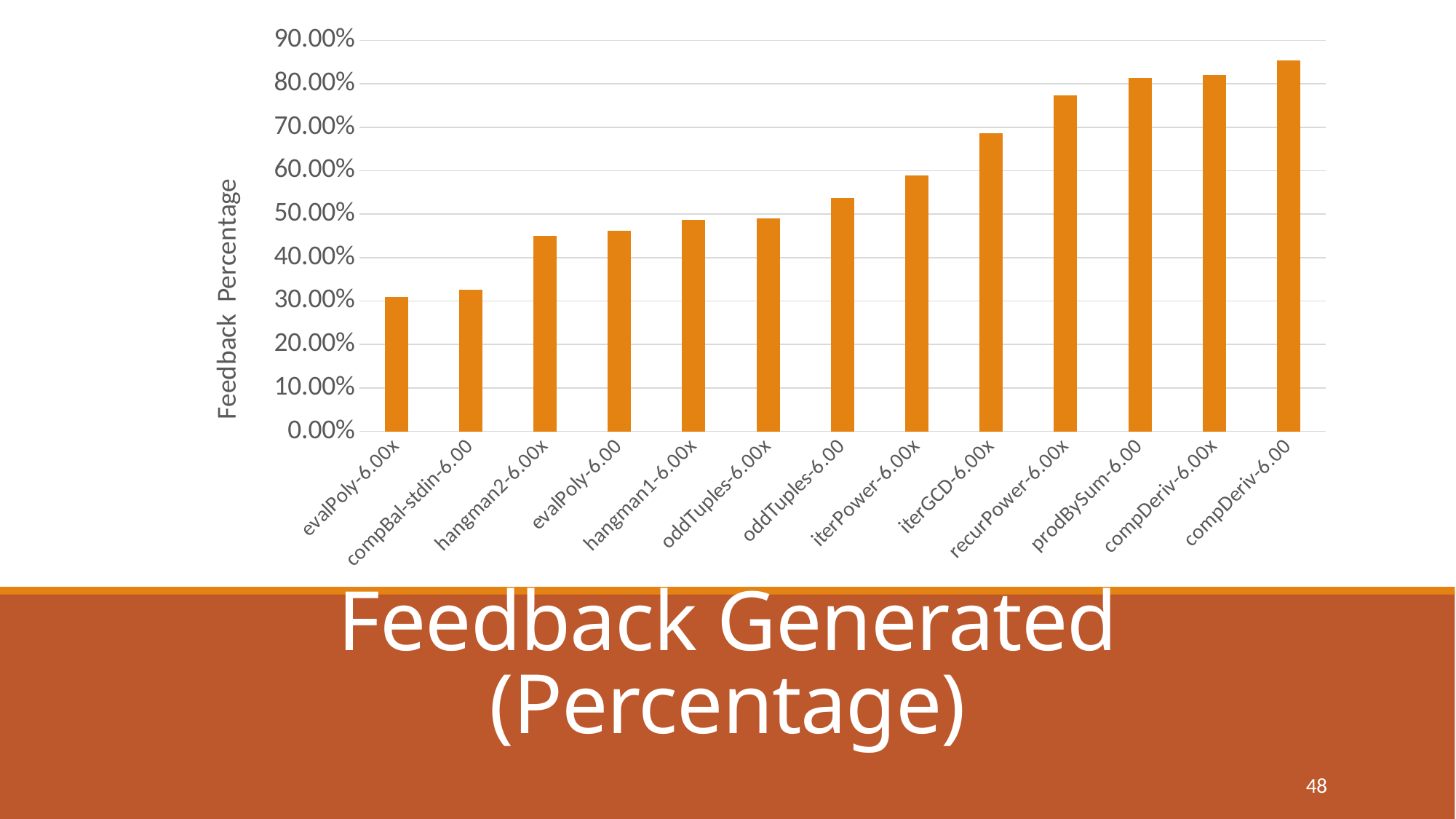
Is the value for recurPower-6.00x greater or less than 80.00%? less Which category has the lowest feedback percentage? evalPoly-6.00x Is the value for evalPoly-6.00x greater or less than 40.00%? less What is the label on the vertical axis of the chart? Feedback Percentage Is the value for compDeriv-6.00 greater or less than 80.00%? greater Which has a higher feedback percentage, iterGCD-6.00x or hangman2-6.00x? iterGCD-6.00x Which category has the highest feedback percentage? compDeriv-6.00 Do the bar values rise or fall from left to right along the x axis? rise What kind of chart is shown on the slide? bar chart How many categories are plotted on the x axis of the chart? 13